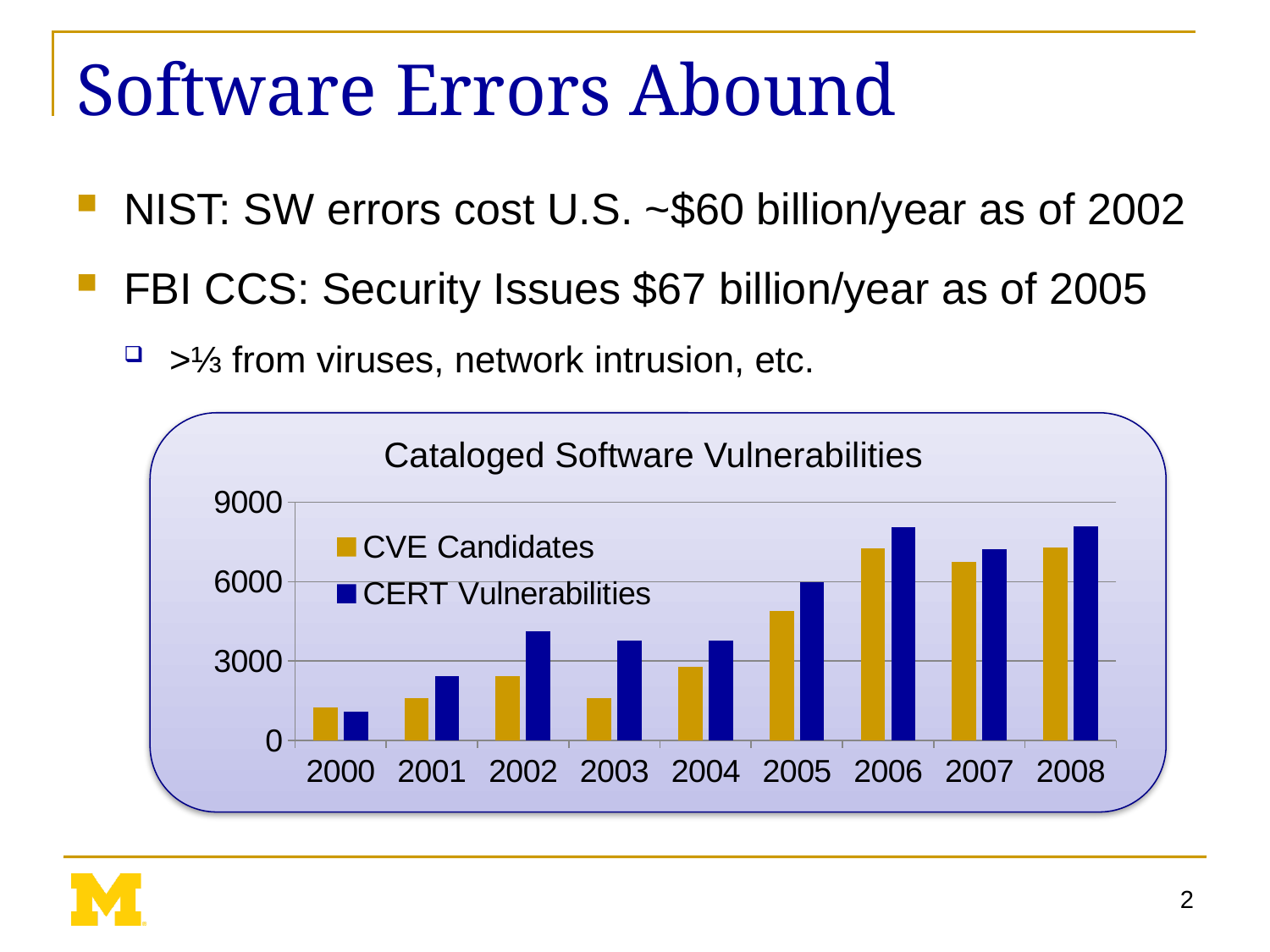
How many series does the chart's legend list? 2 Do the CERT Vulnerabilities values generally rise or fall from 2000 to 2008? Rise Is the value for CVE Candidates in 2000 greater or less than 3000? less In 2002, which is larger: CVE Candidates or CERT Vulnerabilities? CERT Vulnerabilities What is the title of the chart? Cataloged Software Vulnerabilities What kind of chart is shown on the slide? Bar chart Which year has the lowest value for CERT Vulnerabilities? 2000 Which series is drawn in blue in the chart? CERT Vulnerabilities How many years are shown along the x axis of the chart? 9 Is the value for CVE Candidates in 2005 greater or less than 3000? greater Is the value for CERT Vulnerabilities in 2002 greater or less than 3000? greater